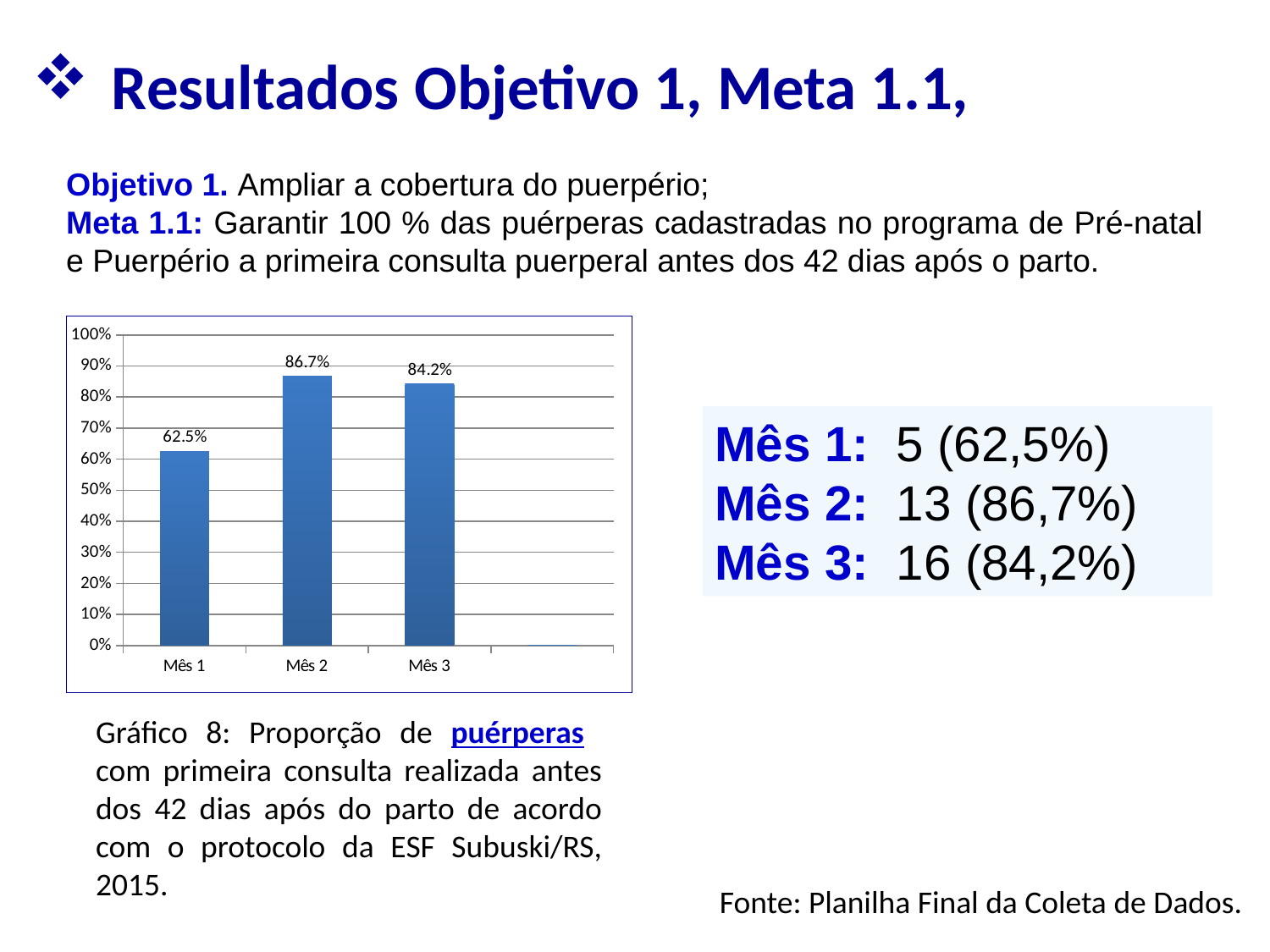
Which month has the lowest value in the chart? Mês 1 What is the value for Mês 3 in the chart? 84.2% What is the difference between the values for Mês 2 and Mês 1? 24.2 percentage points How many months are labeled on the x axis of the chart? 3 Is the value for Mês 1 greater or less than 70%? less Which is larger, the value for Mês 3 or the value for Mês 1? Mês 3 What kind of chart is shown on the slide? bar chart What is the value for Mês 2 in the chart? 86.7% Do the values rise or fall from Mês 2 to Mês 3? fall What is the difference between the values for Mês 2 and Mês 3? 2.5 percentage points What is the value for Mês 1 in the chart? 62.5% Which month has the highest value in the chart? Mês 2